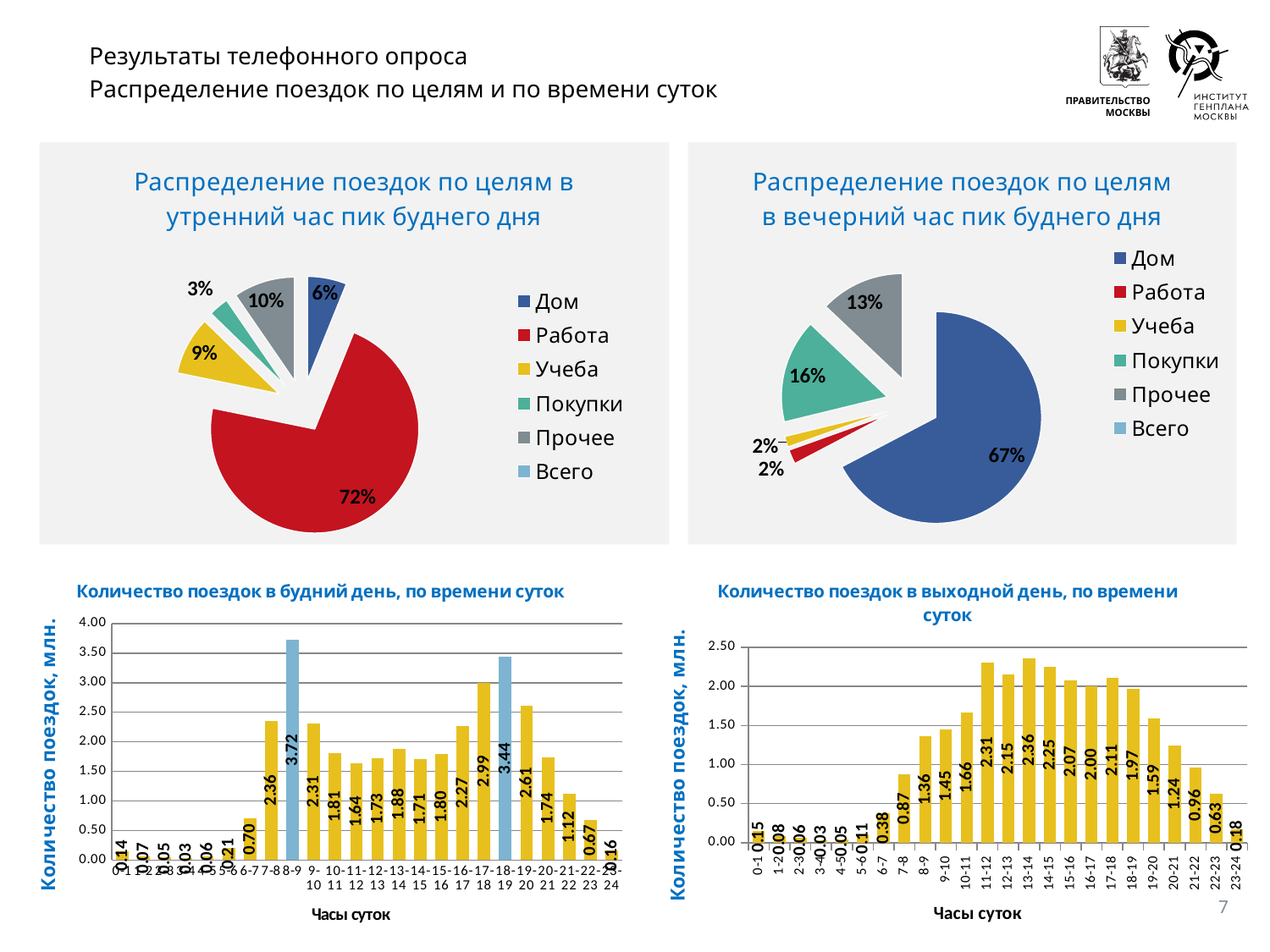
In the chart 'Количество поездок в будний день, по времени суток', which hour interval has the highest value? 8-9 In the chart 'Количество поездок в выходной день, по времени суток', which hour interval has the highest value? 13-14 In the chart 'Количество поездок в выходной день, по времени суток', what is the value for 11-12? 2.31 What kind of chart is 'Количество поездок в выходной день, по времени суток'? bar chart In the pie chart 'Распределение поездок по целям в утренний час пик буднего дня', what share is labelled for Работа? 72% In the chart 'Количество поездок в будний день, по времени суток', what is the difference between the values for 8-9 and 18-19? 0.28 In the pie chart 'Распределение поездок по целям в утренний час пик буднего дня', which category has the smallest labelled share? Покупки In the pie chart 'Распределение поездок по целям в вечерний час пик буднего дня', what share is labelled for Дом? 67% In the pie chart 'Распределение поездок по целям в вечерний час пик буднего дня', what is the difference between the shares for Покупки and Прочее? 3% How many entries does the legend of the pie chart 'Распределение поездок по целям в утренний час пик буднего дня' list? 6 In the chart 'Количество поездок в будний день, по времени суток', what is the value for 8-9? 3.72 In the pie chart 'Распределение поездок по целям в вечерний час пик буднего дня', which is larger, the share for Покупки or the share for Прочее? Покупки